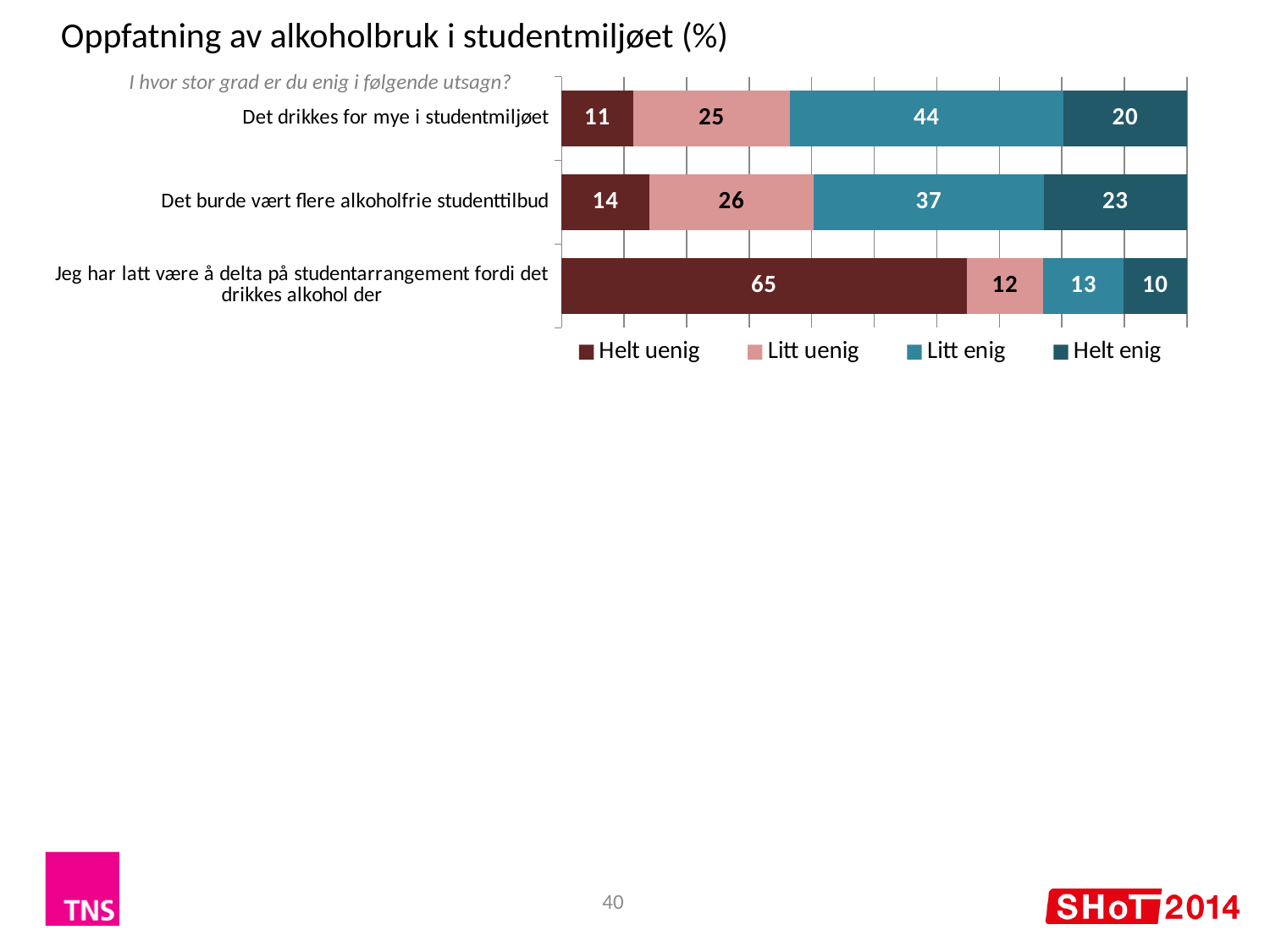
What is the value for "Litt enig" for "Det burde vært flere alkoholfrie studenttilbud"? 37 Which statement has the lowest "Helt enig" value? Jeg har latt være å delta på studentarrangement fordi det drikkes alkohol der What is the difference between the "Litt enig" values for "Det drikkes for mye i studentmiljøet" and "Det burde vært flere alkoholfrie studenttilbud"? 7 How many statements (categories) are shown in the chart? 3 What is the total of the stacked bar for "Det drikkes for mye i studentmiljøet"? 100 What is the value for "Helt uenig" for "Jeg har latt være å delta på studentarrangement fordi det drikkes alkohol der"? 65 What kind of chart is shown on the slide? Stacked bar chart Which statement has the highest "Helt uenig" value? Jeg har latt være å delta på studentarrangement fordi det drikkes alkohol der Which is larger: "Litt uenig" for "Det drikkes for mye i studentmiljøet" or "Litt uenig" for "Det burde vært flere alkoholfrie studenttilbud"? Det burde vært flere alkoholfrie studenttilbud What is the value for "Helt enig" for "Det burde vært flere alkoholfrie studenttilbud"? 23 How many series does the legend list? 4 What is the value for "Helt uenig" for "Det drikkes for mye i studentmiljøet"? 11